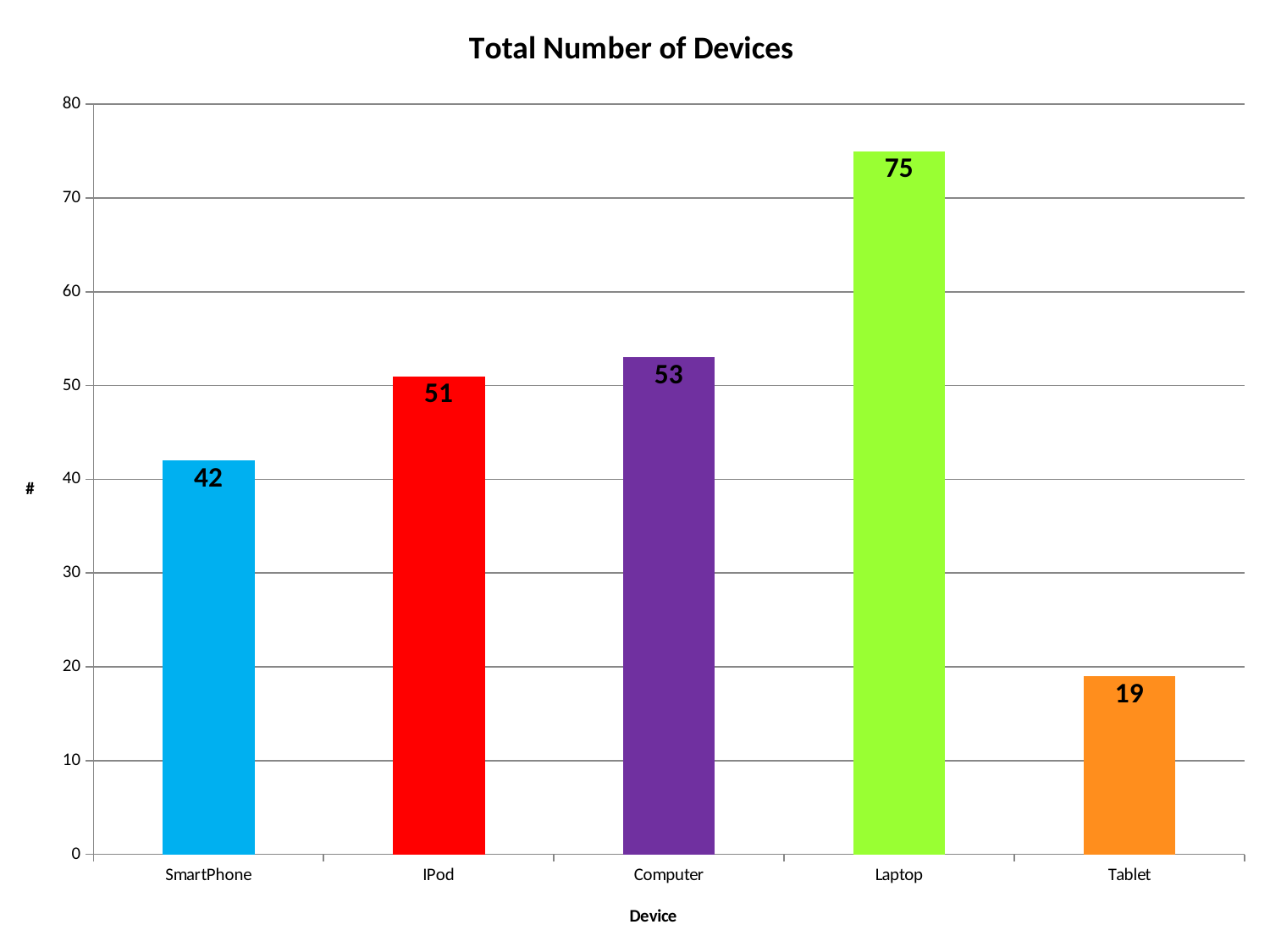
Which is larger, the value for SmartPhone or the value for IPod? IPod Which device has the lowest value? Tablet What kind of chart is this? bar chart What is the difference between the values for Computer and SmartPhone? 11 How many devices are shown on the x axis? 5 Is the value for Computer greater or less than 50? greater What is the title of the chart? Total Number of Devices Which device has the highest value? Laptop What is the value for Laptop? 75 What is the value for IPod? 51 What is the difference between the values for Laptop and Tablet? 56 What is the value for Tablet? 19